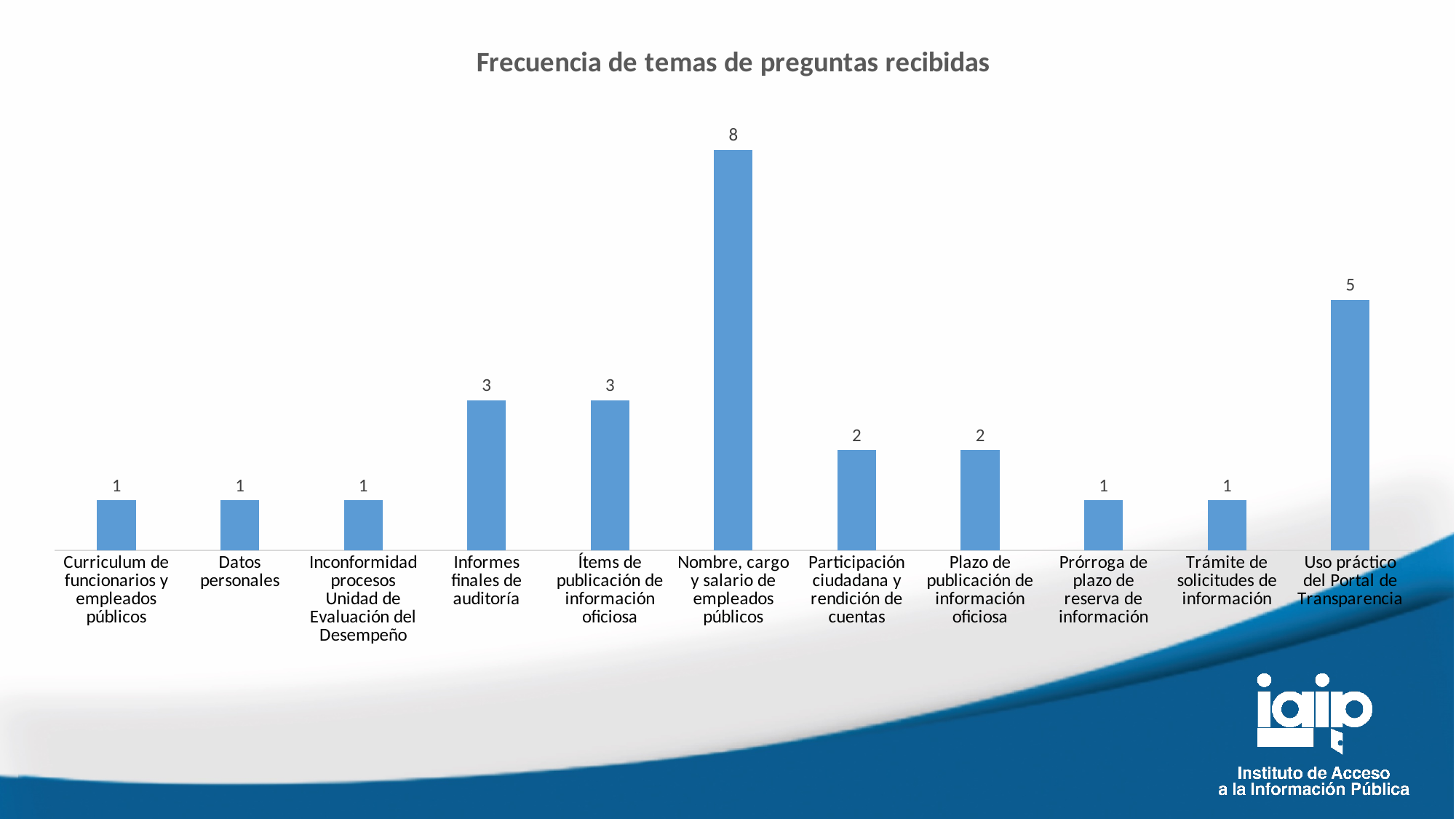
Which is larger, the value for 'Ítems de publicación de información oficiosa' or the value for 'Plazo de publicación de información oficiosa'? Ítems de publicación de información oficiosa What is the value for 'Nombre, cargo y salario de empleados públicos'? 8 What is the value for 'Participación ciudadana y rendición de cuentas'? 2 What is the difference between the values for 'Informes finales de auditoría' and 'Prórroga de plazo de reserva de información'? 2 What kind of chart is shown on the slide? Bar chart What is the difference between the values for 'Nombre, cargo y salario de empleados públicos' and 'Uso práctico del Portal de Transparencia'? 3 What is the title of the chart? Frecuencia de temas de preguntas recibidas Which category has the highest value? Nombre, cargo y salario de empleados públicos What is the value for 'Datos personales'? 1 How many categories are shown in the chart? 11 What is the value for 'Uso práctico del Portal de Transparencia'? 5 What is the value for 'Informes finales de auditoría'? 3